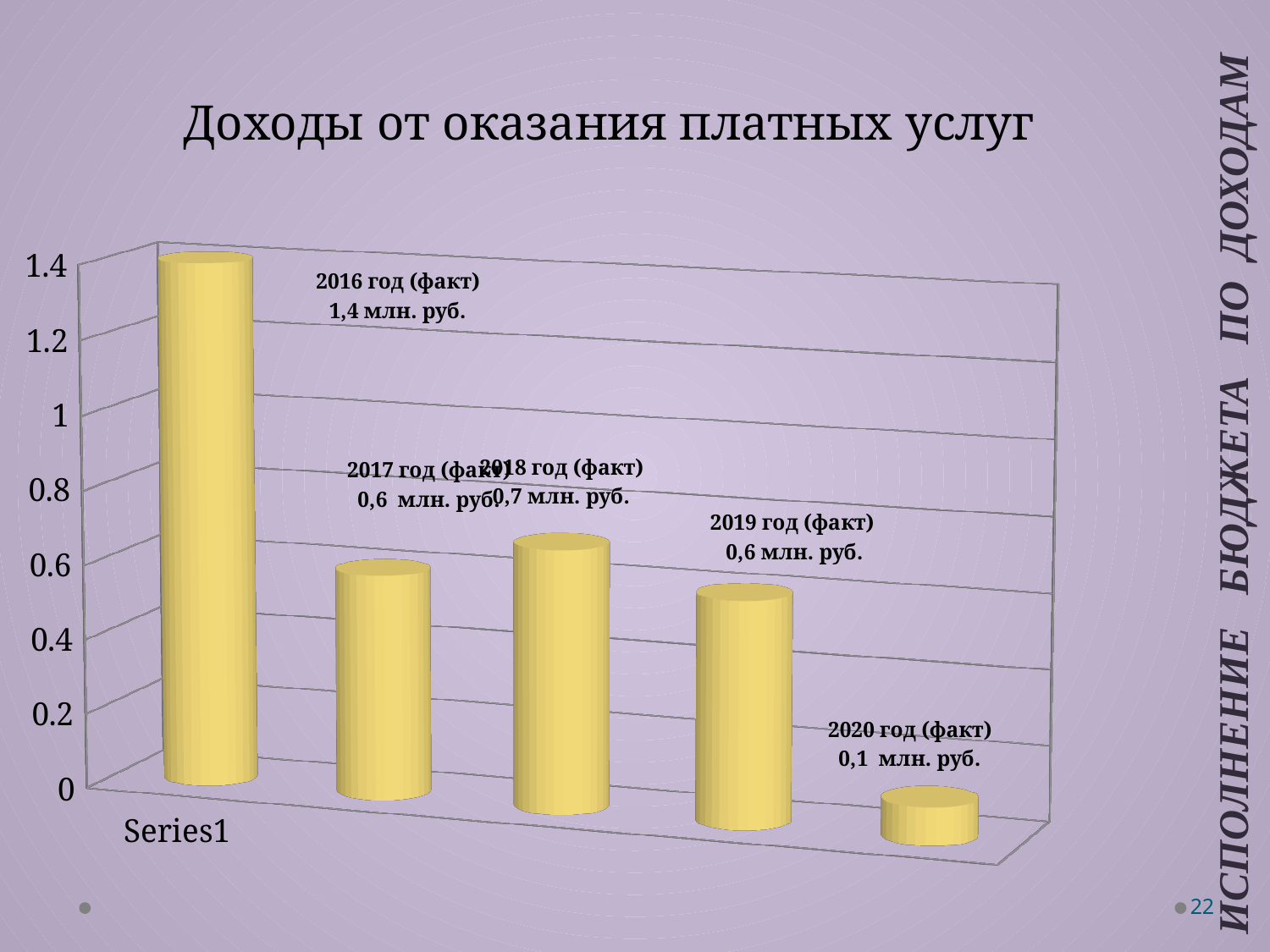
What is the title of the chart? Доходы от оказания платных услуг What is the difference between the values for 2016 and 2020? 1,3 млн. руб. Which is larger, the value for 2018 or the value for 2019? 2018 What type of chart is shown on the slide? bar chart Which year has the lowest value in the chart? 2020 год (факт) Is the value for 2016 greater or less than 1? greater What is the highest tick value shown on the vertical axis? 1.4 How many bars are plotted in the chart? 5 What is the value labelled for 2018 год (факт)? 0,7 млн. руб. What is the value labelled for 2016 год (факт)? 1,4 млн. руб. Which year has the highest value in the chart? 2016 год (факт) What is the value labelled for 2020 год (факт)? 0,1 млн. руб.